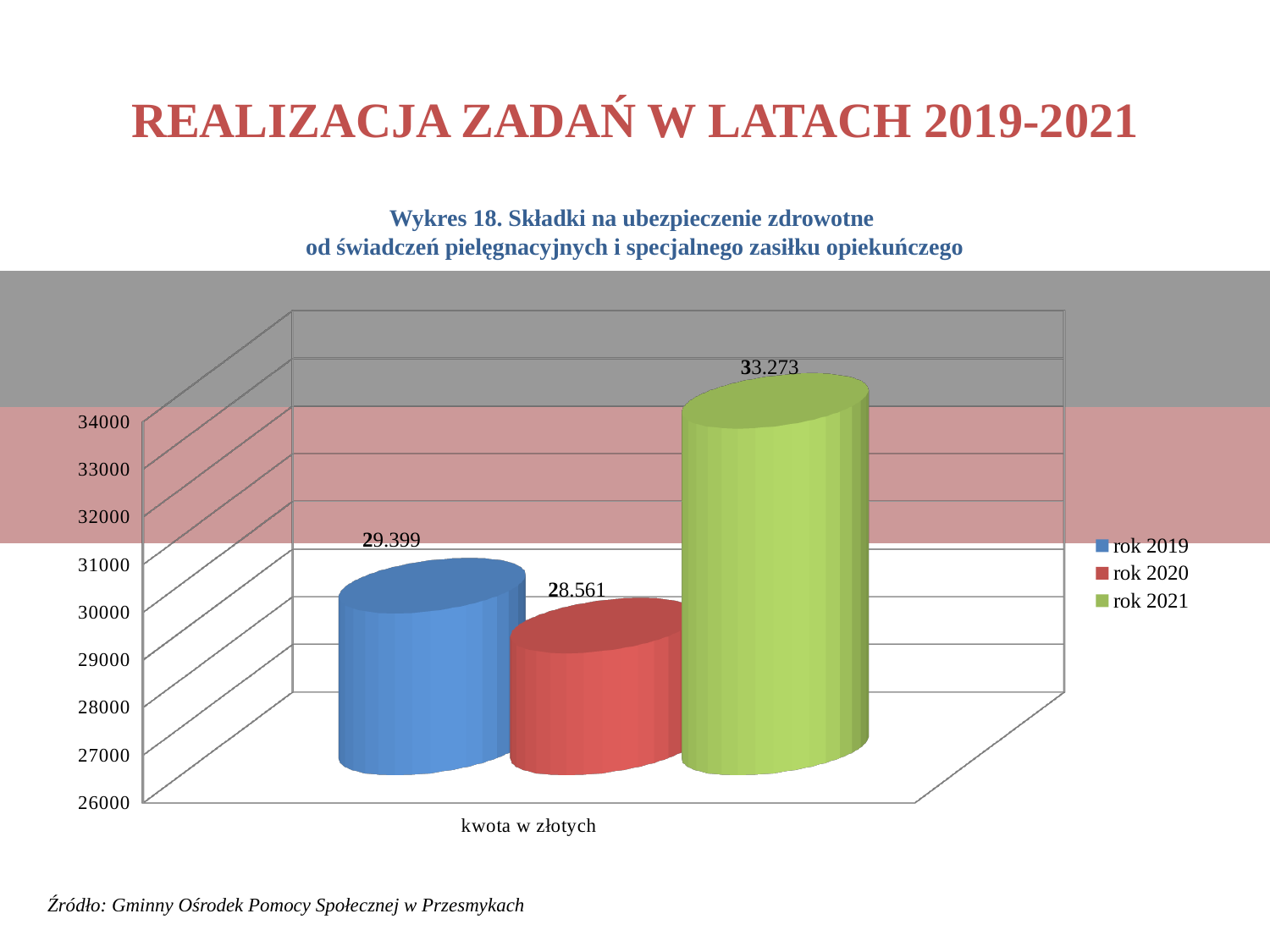
Is the value for rok 2021 greater or less than 32000? greater What is the difference between the values for rok 2021 and rok 2019? 3.874 What kind of chart is shown on the slide? bar chart How many series does the legend list? 3 What is the value for rok 2019? 29.399 What is the value for rok 2021? 33.273 Which year has the lowest value? rok 2020 What is the difference between the values for rok 2019 and rok 2020? 838 What is the label on the x axis of the chart? kwota w złotych Which year has the highest value? rok 2021 Which is larger, the value for rok 2019 or rok 2020? rok 2019 What is the value for rok 2020? 28.561